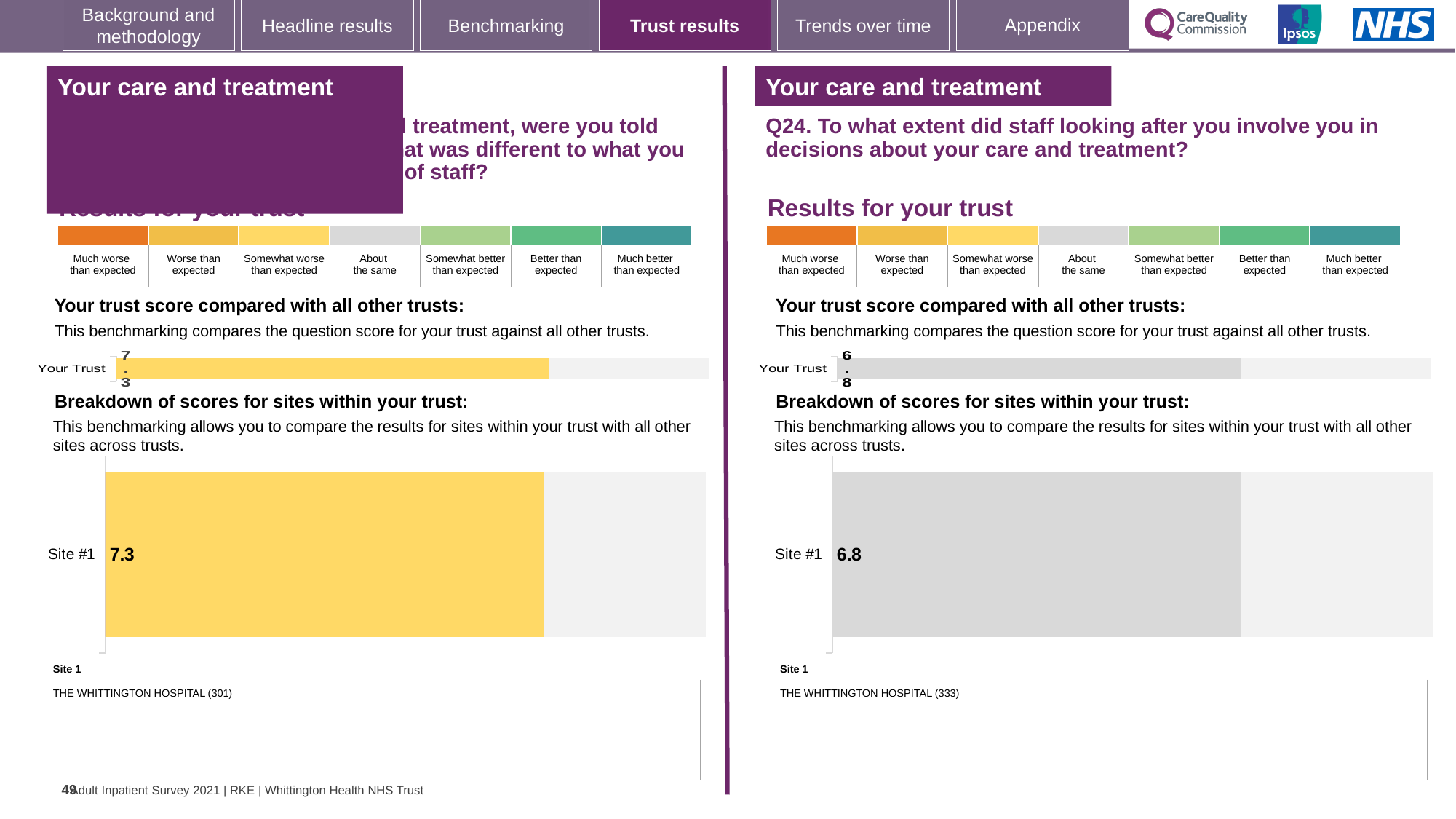
On the right panel (Q24) 'Your trust score compared with all other trusts' chart, what is the score for Your Trust? 6.8 On the right panel (Q24) 'Breakdown of scores for sites within your trust' chart, what is the score for Site #1? 6.8 Which is larger: the Your Trust score on the left panel or the Your Trust score on the right panel (Q24)? Left panel (7.3) What colour is the Your Trust bar on the right panel (Q24) chart? Grey On the left panel's 'Breakdown of scores for sites within your trust' chart, what is the score for Site #1? 7.3 What type of chart is used to show the Site #1 score on the right panel (Q24)? Bar chart On the right panel (Q24), is the Site #1 score greater or less than 7? less On the left panel's 'Your trust score compared with all other trusts' chart, what is the score for Your Trust? 7.3 What is the difference between the Site #1 score on the left panel and the Site #1 score on the right panel (Q24)? 0.5 Which site is listed as Site 1 on the right panel (Q24)? THE WHITTINGTON HOSPITAL (333) How many sites are shown in the left panel's 'Breakdown of scores for sites within your trust' chart? 1 What colour is the Site #1 bar on the left panel's breakdown chart? Yellow